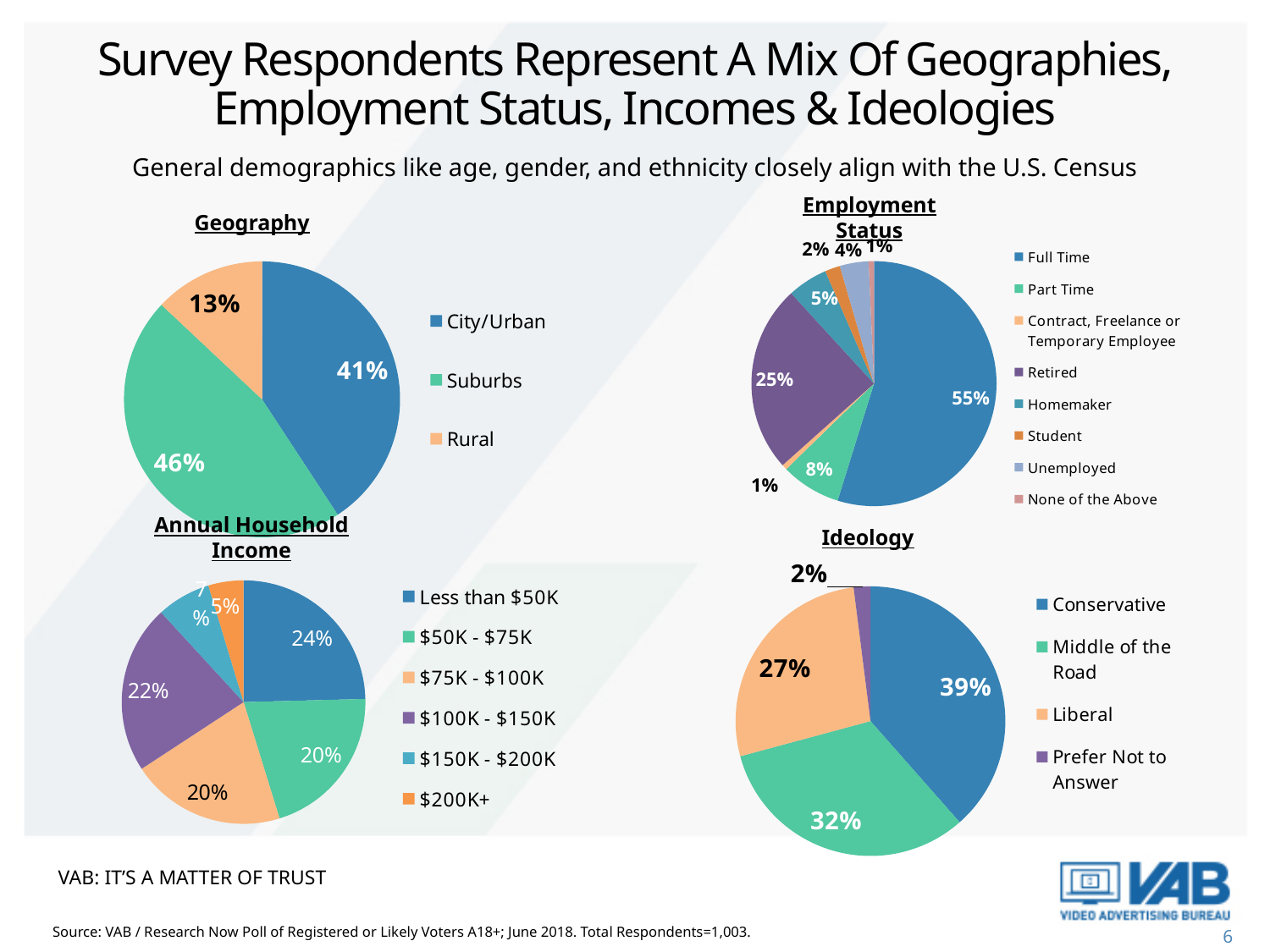
In the Geography chart, what percentage of respondents are from Suburbs? 46% In the Annual Household Income chart, what percentage of respondents earn $100K - $150K? 22% In the Annual Household Income chart, what percentage of respondents earn Less than $50K? 24% In the Geography chart, which category has the smallest share? Rural How many categories does the legend of the Employment Status chart list? 8 In the Ideology chart, what is the difference between the Conservative and Liberal shares? 12% In the Employment Status chart, what percentage of respondents are Retired? 25% In the Employment Status chart, which is larger: Part Time or Homemaker? Part Time In the Geography chart, what is the difference between the Suburbs and City/Urban shares? 5% In the Ideology chart, which category has the largest share? Conservative What type of chart is used for the Ideology data? Pie chart In the Employment Status chart, what percentage of respondents are Full Time? 55%